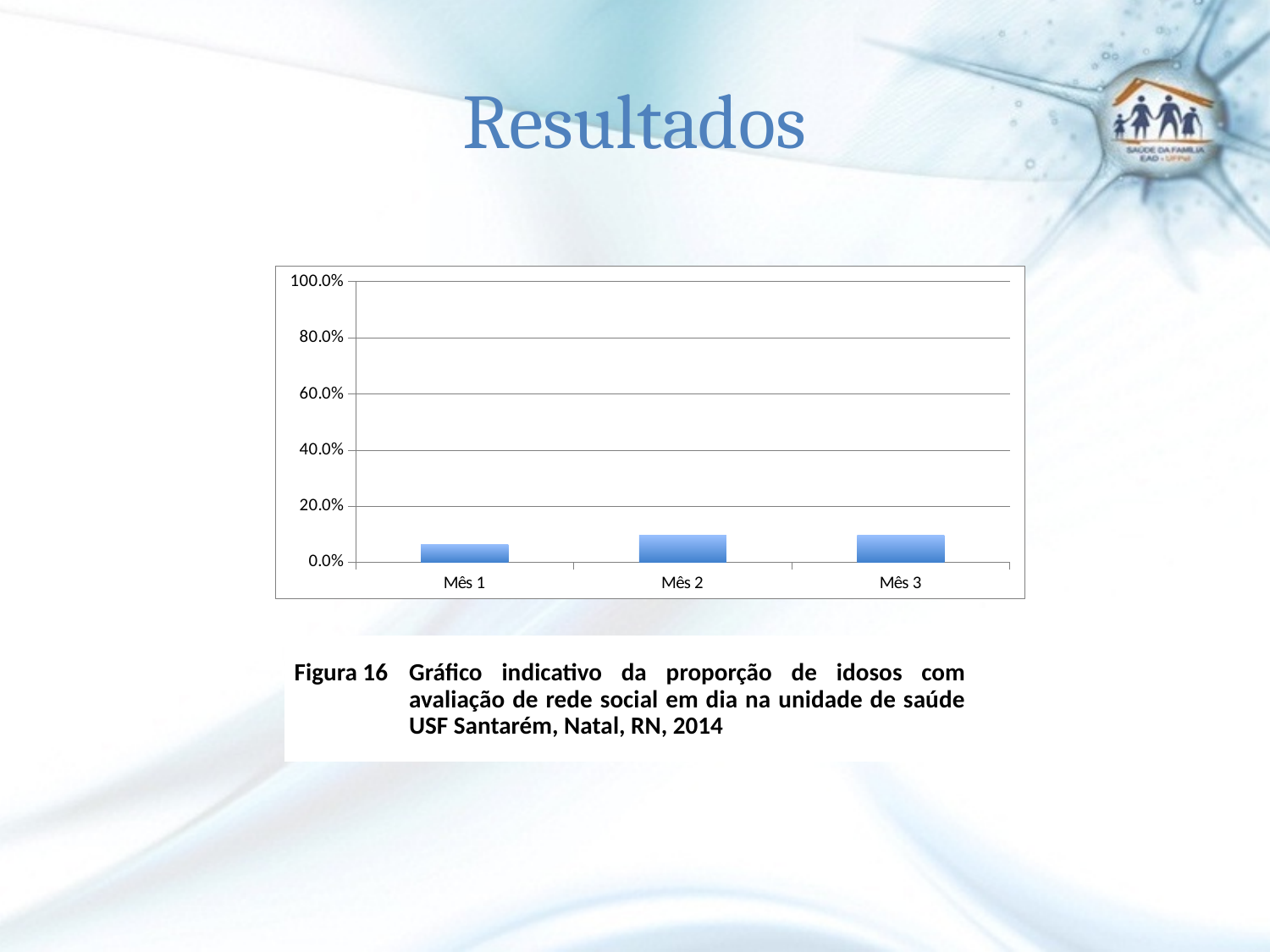
Is the value for Mês 2 greater or less than 20.0%? less What kind of chart is shown on the slide? bar chart Which is larger, the value for Mês 1 or the value for Mês 3? Mês 3 Which is larger, the value for Mês 1 or the value for Mês 2? Mês 2 How many categories are shown on the x axis of the chart? 3 Which month has the lowest value in the chart? Mês 1 Is the value for Mês 3 greater or less than 40.0%? less What figure number is given in the caption below the chart? Figura 16 What is the highest value shown on the y axis of the chart? 100.0% Is the value for Mês 1 greater or less than 20.0%? less